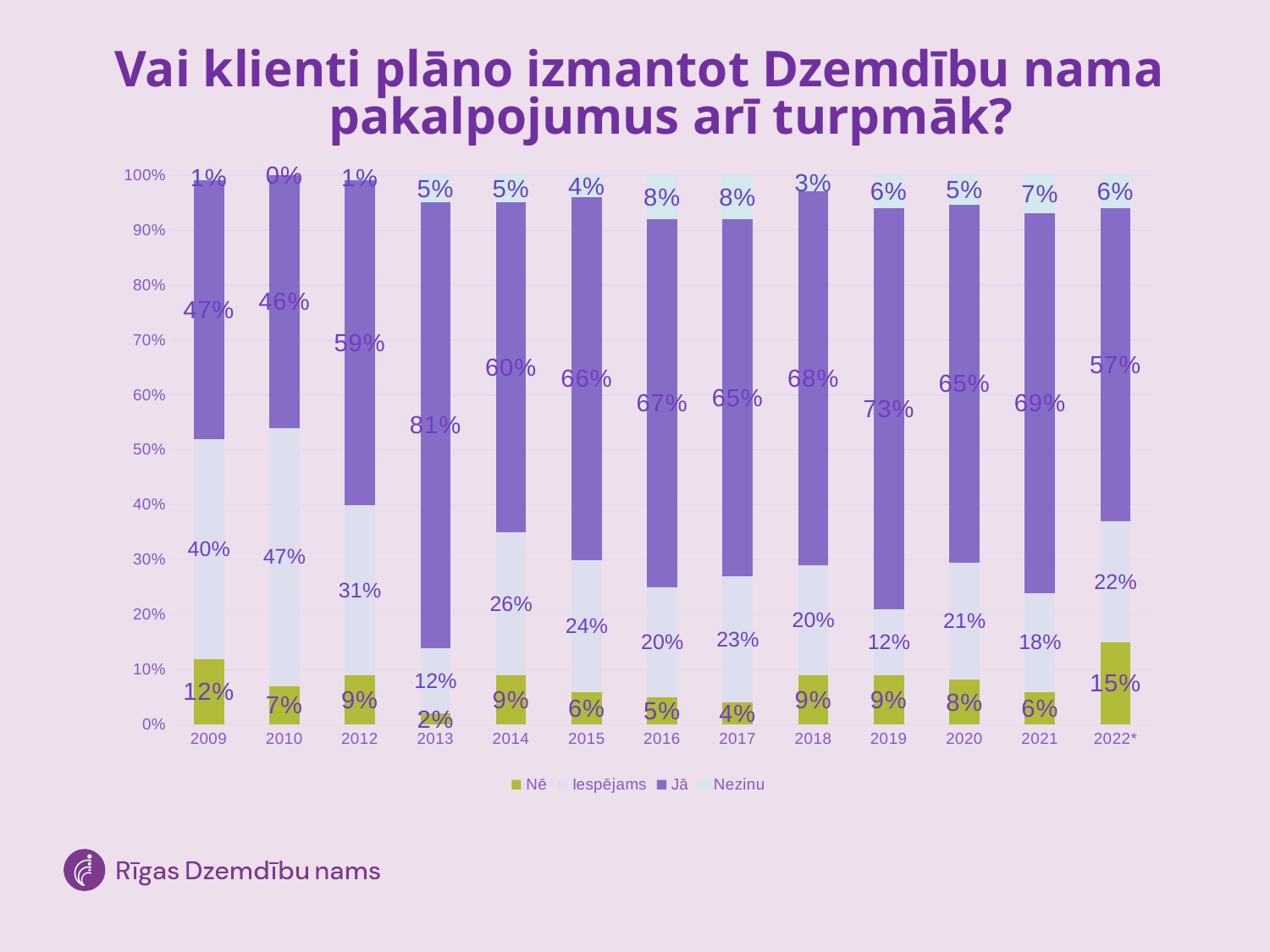
What is the difference between the Jā value for 2013 and the Jā value for 2022*? 24% In which year is the Jā value lowest? 2010 Which series is shown in green in the legend? Nē How many series does the legend list? 4 What is the value of the Jā series for 2013? 81% What is the total of the stacked bar for 2013? 100% How many years are shown on the x axis? 13 Which is larger, the Nē value for 2009 or the Nē value for 2022*? 2022* In which year is the Jā value highest? 2013 What type of chart is shown on the slide? Stacked bar chart What is the value of the Nē series for 2022*? 15% What is the value of the Iespējams series for 2010? 47%